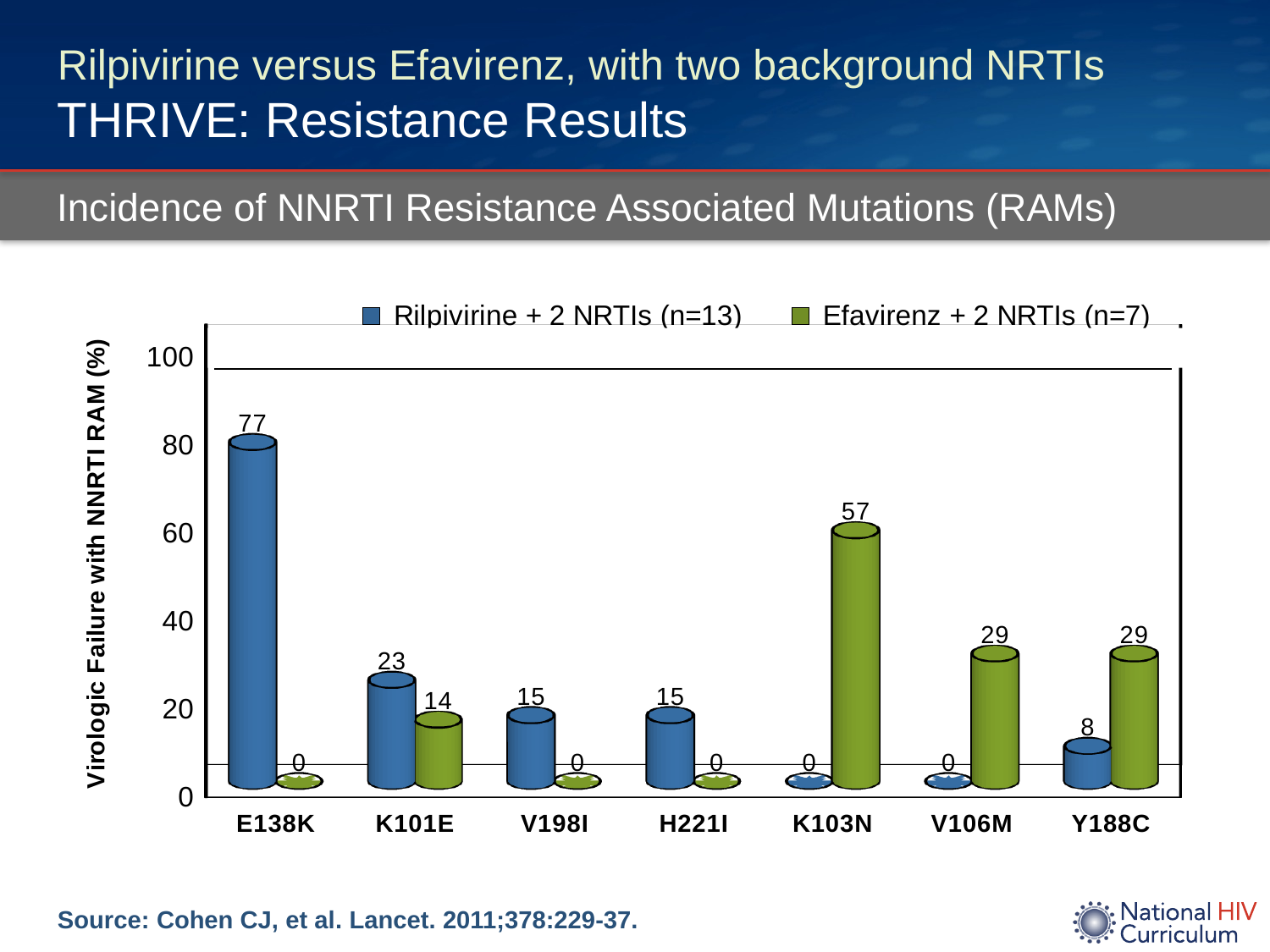
What is the value for Efavirenz + 2 NRTIs at K101E? 14 How many series does the legend list? 2 What is the value for Efavirenz + 2 NRTIs at K103N? 57 What is the value for Rilpivirine + 2 NRTIs at Y188C? 8 What is the label of the y axis? Virologic Failure with NNRTI RAM (%) What kind of chart is shown on the slide? Bar chart Which is larger at Y188C: the Rilpivirine + 2 NRTIs value or the Efavirenz + 2 NRTIs value? Efavirenz + 2 NRTIs What is the value for Rilpivirine + 2 NRTIs at E138K? 77 How many mutations are shown on the x axis? 7 Which mutation has the highest value for Efavirenz + 2 NRTIs? K103N Which mutation has the highest value for Rilpivirine + 2 NRTIs? E138K What is the difference between the Rilpivirine + 2 NRTIs and Efavirenz + 2 NRTIs values at K101E? 9